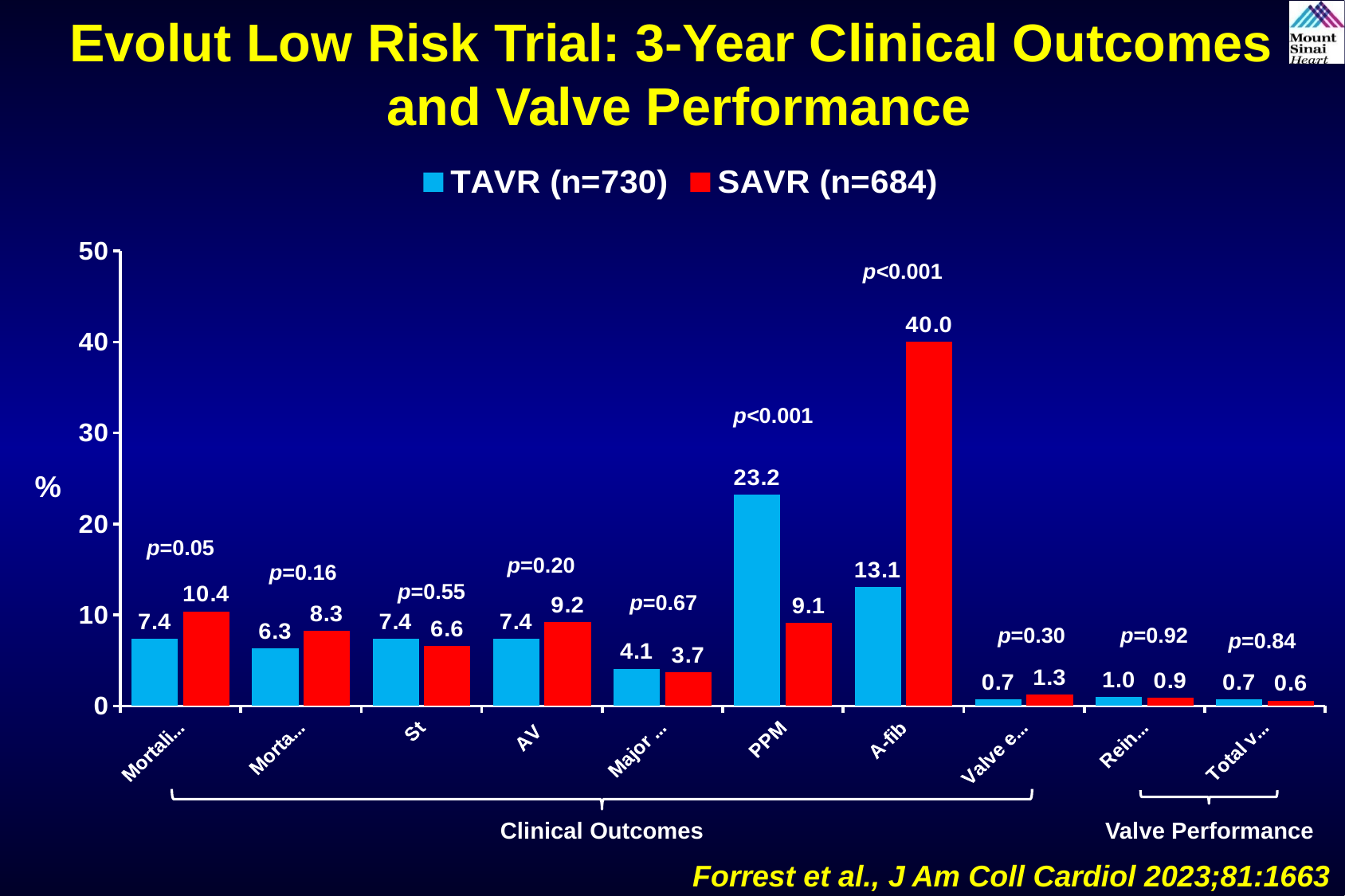
What is the SAVR value for AV? 9.2 What are the two legend entries of the chart? TAVR (n=730) and SAVR (n=684) What is the SAVR value for A-fib? 40.0 What is the difference between the SAVR and TAVR values for A-fib? 26.9 How many series does the legend list? 2 For PPM, which series has the larger value, TAVR or SAVR? TAVR What is the TAVR value for PPM? 23.2 Is the SAVR value for A-fib greater or less than 30? greater What type of chart is shown on the slide? bar chart How many categories are plotted along the x axis? 10 What is the TAVR value for St? 7.4 Which category has the highest bar in the chart? A-fib